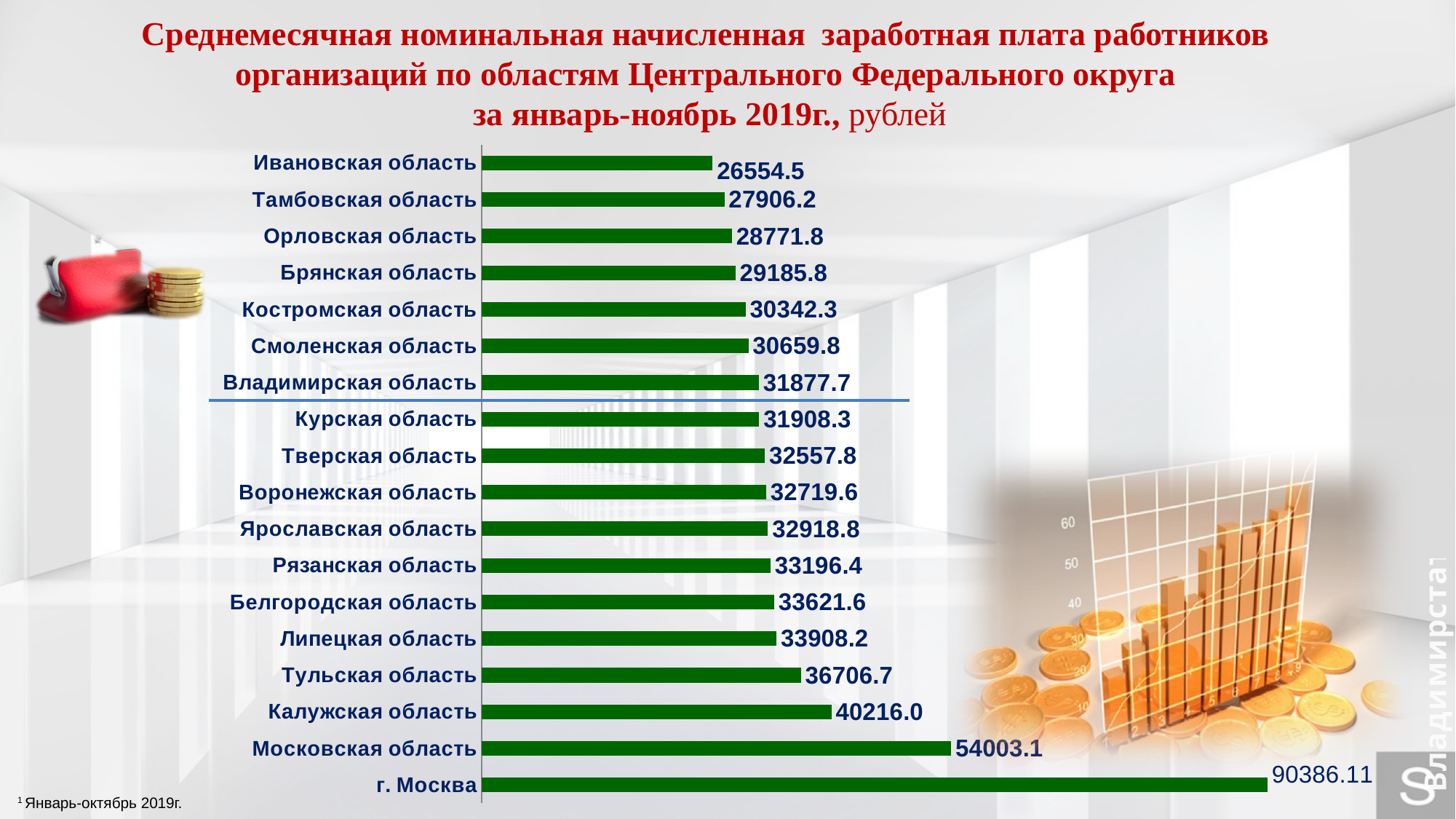
How many regions (categories) are plotted in the chart? 18 What is the value for Владимирская область? 31877.7 Which region has the lowest value in the chart? Ивановская область What is the difference between the values for г. Москва and Московская область? 36383.01 What is the difference between the values for Калужская область and Тульская область? 3509.3 Which has a larger value, Ивановская область or Липецкая область? Липецкая область Which has a larger value, Московская область or Тульская область? Московская область What is the value for Костромская область? 30342.3 Which region has the highest value in the chart? г. Москва What is the value for Калужская область? 40216.0 What type of chart is shown on the slide? bar chart What unit of measurement is stated in the chart title? рублей